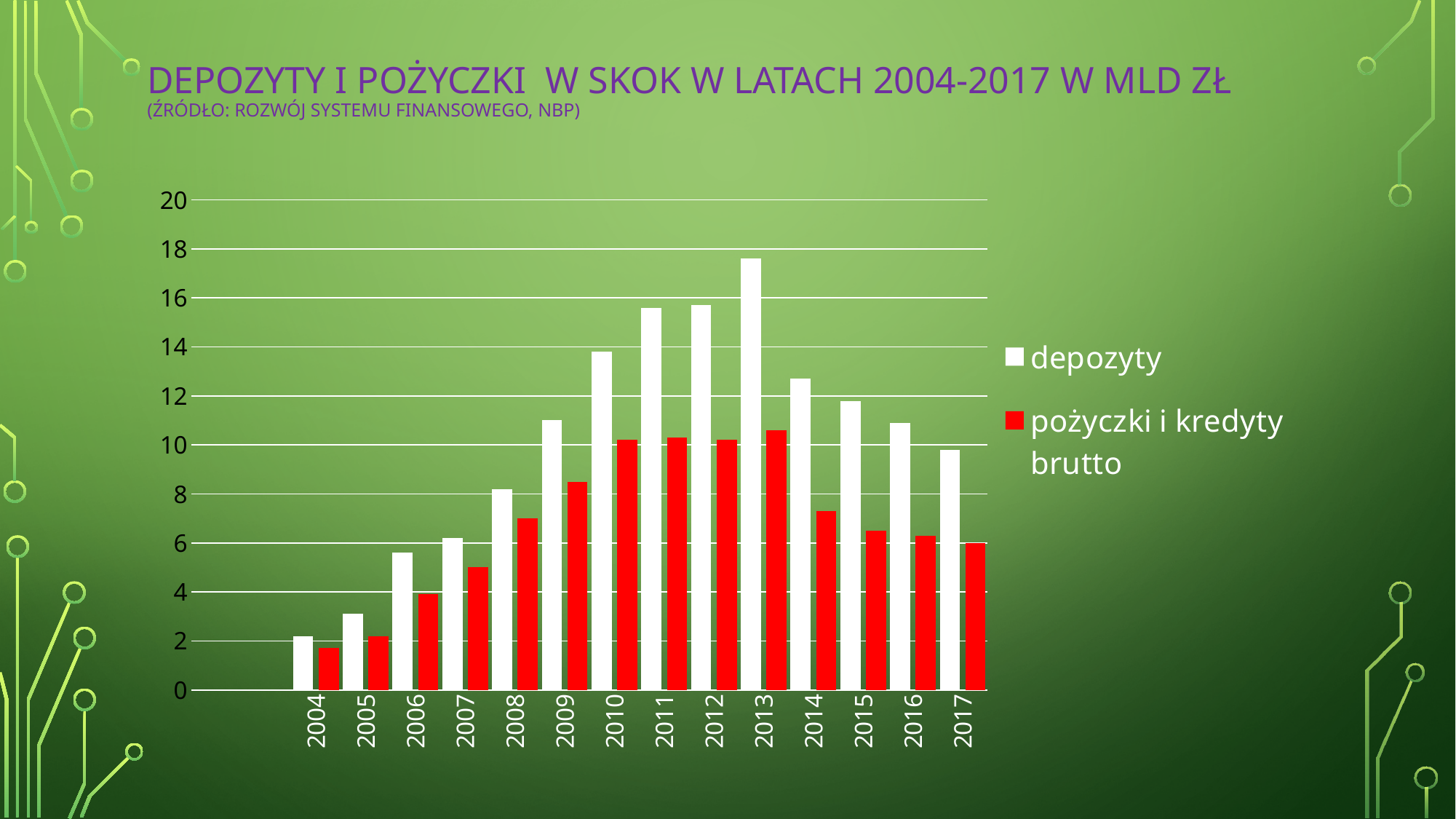
In which year is the value for pożyczki i kredyty brutto lowest? 2004 In which year is the value for depozyty lowest? 2004 Which is larger, the value for depozyty in 2014 or in 2015? 2014 In which year is the value for depozyty highest? 2013 How many years are shown on the x axis? 14 Is the value for depozyty in 2013 greater or less than 16? greater Is the value for pożyczki i kredyty brutto in 2014 greater or less than 8? less Is the value for depozyty in 2017 greater or less than 10? less Do the values for depozyty rise or fall from 2004 to 2013? rise What kind of chart is shown on the slide? bar chart How many series does the legend list? 2